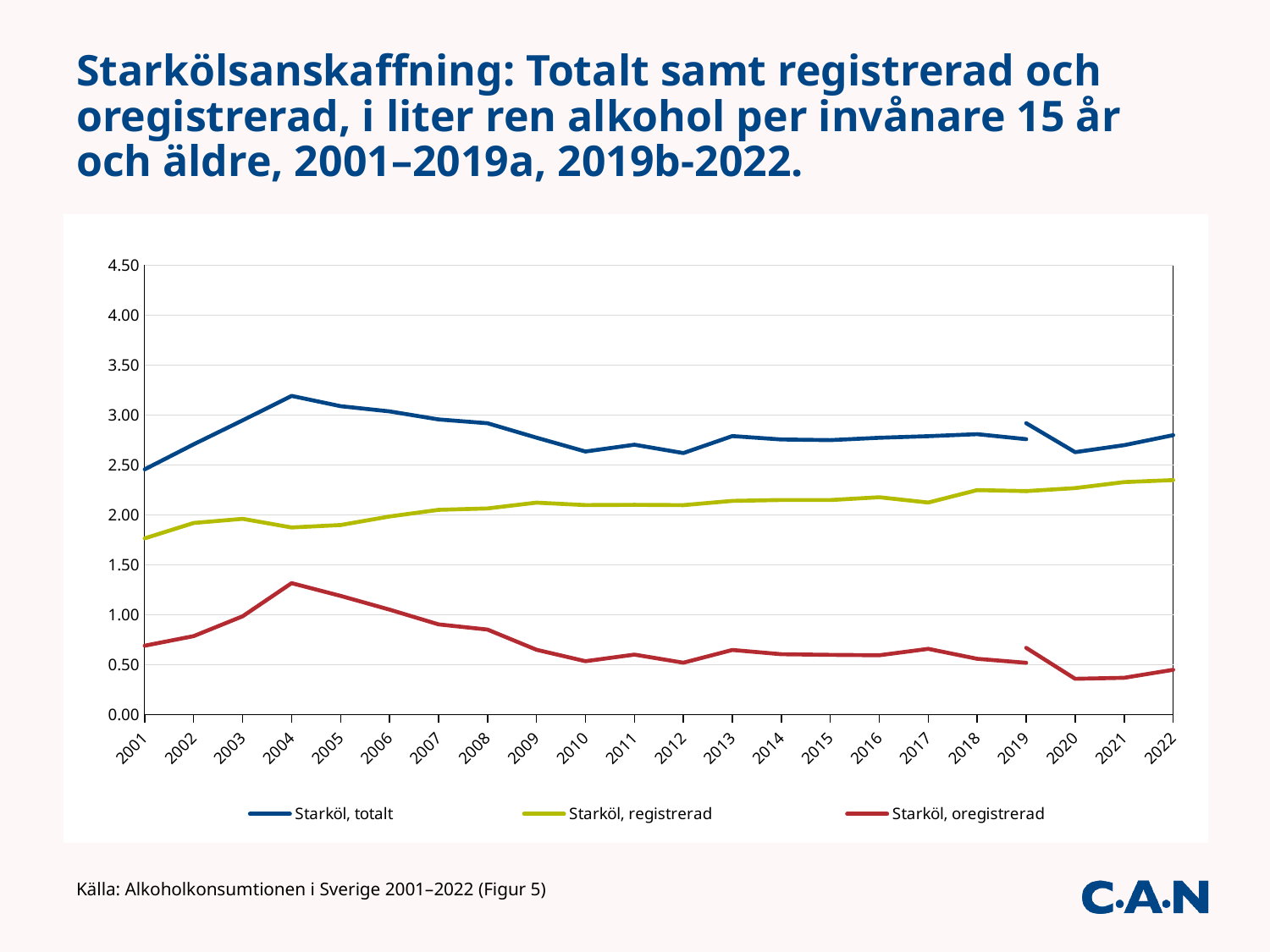
In which year does the Starköl, oregistrerad series reach its highest value? 2004 Is the value for Starköl, oregistrerad in 2004 greater or less than 1.00? greater Which colour is used for the Starköl, registrerad line? Yellow-green Is the value for Starköl, totalt in 2004 greater or less than 3.00? greater How many series does the legend list? 3 Which series has the larger value in 2010, Starköl, registrerad or Starköl, oregistrerad? Starköl, registrerad Is the value for Starköl, oregistrerad in 2020 greater or less than 0.50? less How many years are shown along the x axis? 22 Does the Starköl, oregistrerad series rise or fall between 2004 and 2010? fall What kind of chart is shown on the slide? Line chart In which year does the Starköl, totalt series reach its highest value? 2004